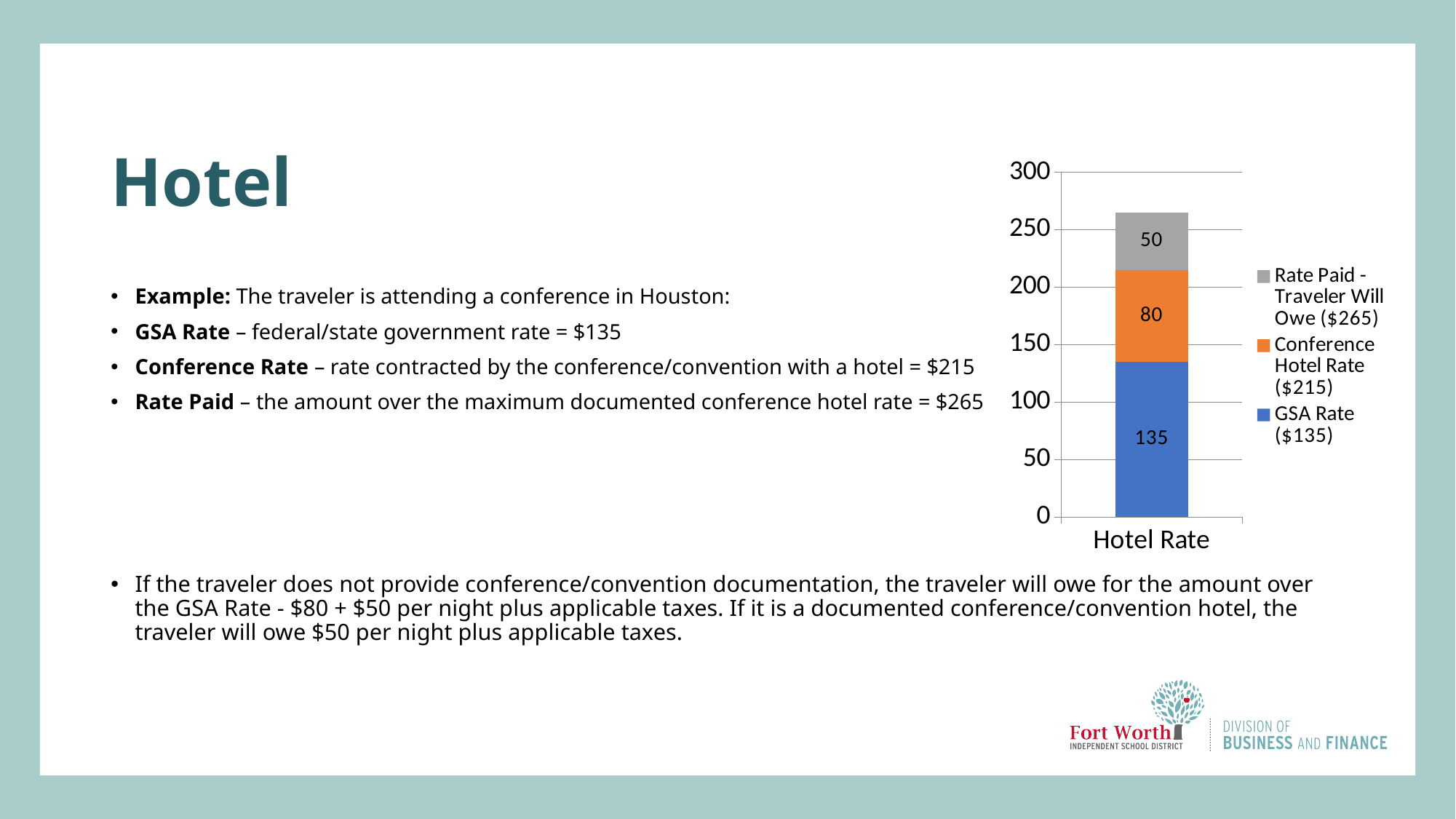
Which segment of the Hotel Rate bar has the largest value? GSA Rate ($135) What is the difference between the GSA Rate segment and the Conference Hotel Rate segment? 55 Is the total height of the Hotel Rate bar greater or less than 250? greater What is the value of the Conference Hotel Rate segment in the Hotel Rate bar? 80 How many series does the legend list? 3 What is the value of the Rate Paid - Traveler Will Owe segment in the Hotel Rate bar? 50 What colour is the GSA Rate segment in the chart? Blue Which segment of the Hotel Rate bar has the smallest value? Rate Paid - Traveler Will Owe ($265) What is the total of the stacked Hotel Rate bar? 265 Which is larger, the Conference Hotel Rate segment or the Rate Paid - Traveler Will Owe segment? Conference Hotel Rate What kind of chart is shown on the slide? Stacked bar chart What is the value of the GSA Rate segment in the Hotel Rate bar? 135